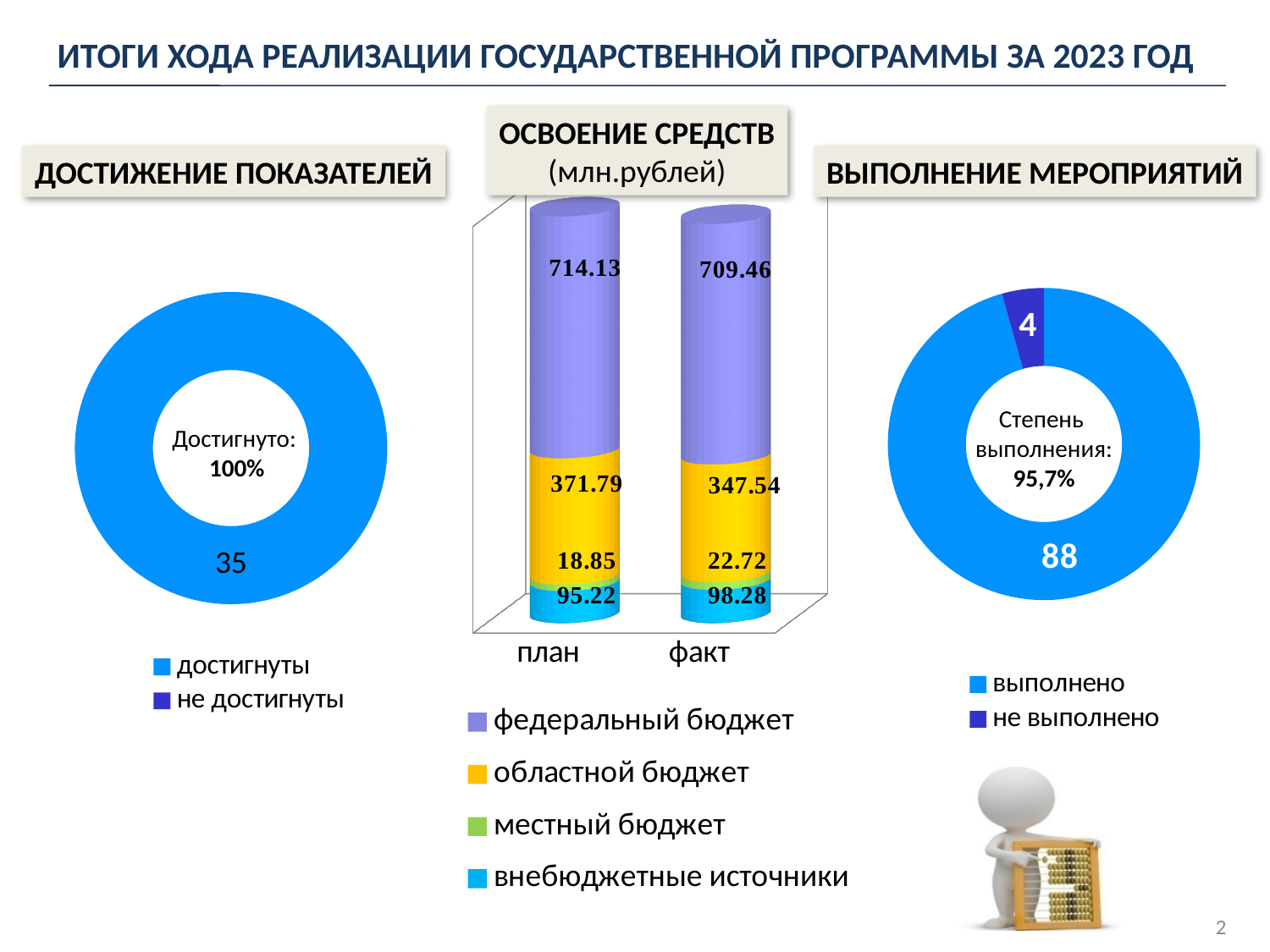
On the chart titled ОСВОЕНИЕ СРЕДСТВ, what is the total of the факт bar? 1178.00 On the chart titled ОСВОЕНИЕ СРЕДСТВ, which is larger: областной бюджет for план or for факт? план On the chart titled ДОСТИЖЕНИЕ ПОКАЗАТЕЛЕЙ, what is the value for достигнуты? 35 What kind of chart is the chart titled ДОСТИЖЕНИЕ ПОКАЗАТЕЛЕЙ? doughnut chart On the chart titled ВЫПОЛНЕНИЕ МЕРОПРИЯТИЙ, what is the value for не выполнено? 4 On the chart titled ВЫПОЛНЕНИЕ МЕРОПРИЯТИЙ, what share of the total does выполнено represent? 95,7% On the chart titled ОСВОЕНИЕ СРЕДСТВ, what is the value of областной бюджет for факт? 347.54 On the chart titled ОСВОЕНИЕ СРЕДСТВ, what is the difference between the федеральный бюджет values for план and факт? 4.67 What kind of chart is the chart titled ОСВОЕНИЕ СРЕДСТВ? stacked bar chart On the chart titled ОСВОЕНИЕ СРЕДСТВ, how many series does the legend list? 4 On the chart titled ОСВОЕНИЕ СРЕДСТВ, what is the value of федеральный бюджет for план? 714.13 On the chart titled ОСВОЕНИЕ СРЕДСТВ, what is the value of внебюджетные источники for план? 95.22